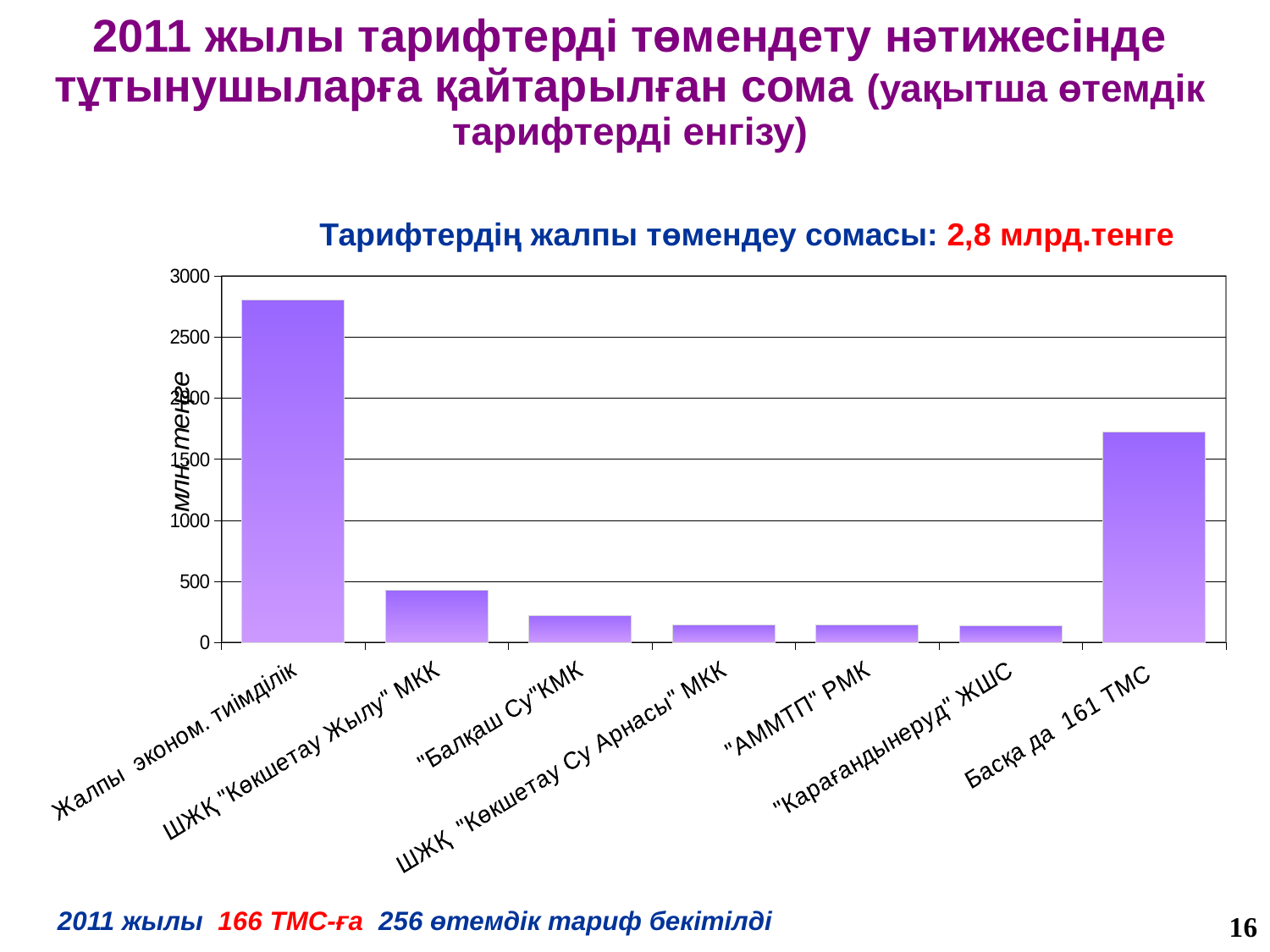
Is the value for "Басқа да 161 ТМС" greater or less than 1500? greater Which is larger: the value for "Басқа да 161 ТМС" or the value for ШЖҚ "Көкшетау Жылу" МКК? Басқа да 161 ТМС What kind of chart is shown on the slide? bar chart How many categories are shown on the x axis of the chart? 7 What unit is given on the y axis of the chart? млн.тенге Is the value for ШЖҚ "Көкшетау Жылу" МКК greater or less than 500? less Is the value for "Басқа да 161 ТМС" greater or less than 2000? less Which is larger: the value for ШЖҚ "Көкшетау Жылу" МКК or the value for "Балқаш Су" КМК? ШЖҚ "Көкшетау Жылу" МКК Which category has the highest bar in the chart? Жалпы эконом. тиімділік What total amount of tariff reduction is stated in the chart title? 2,8 млрд.тенге